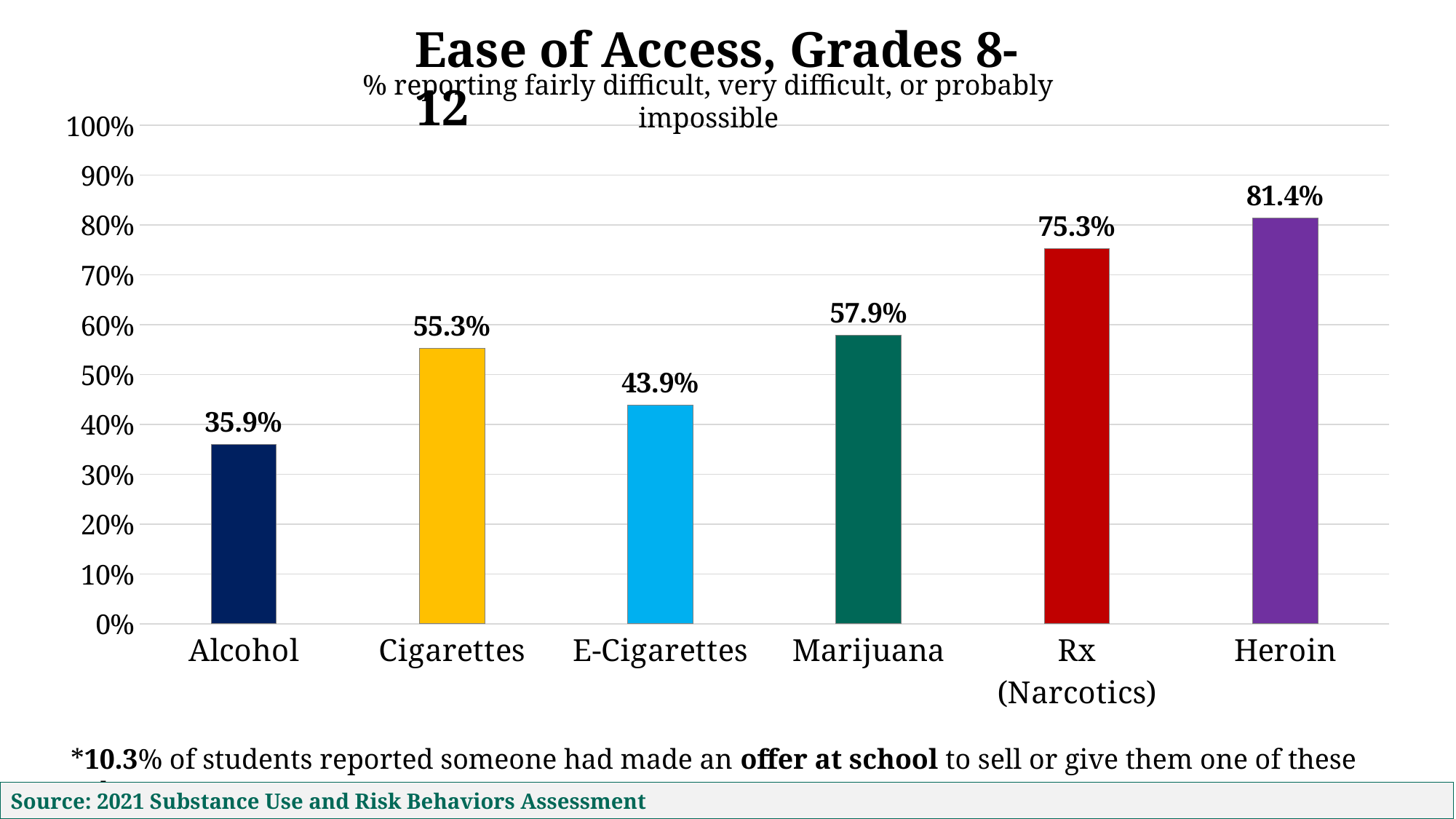
Which category has the lowest value? Alcohol Which category has the highest value? Heroin What percentage is reported for E-Cigarettes? 43.9% What kind of chart is shown on the slide? bar chart What is the source cited at the bottom of the slide? 2021 Substance Use and Risk Behaviors Assessment How many categories are shown on the chart? 6 Which is larger, the value for Cigarettes or the value for E-Cigarettes? Cigarettes What percentage is shown for Heroin? 81.4% What is the difference between the values for Heroin and Alcohol? 45.5% What is the difference between the values for Rx (Narcotics) and Marijuana? 17.4% What is the value for Alcohol? 35.9% Is the value for Marijuana greater or less than 50%? greater